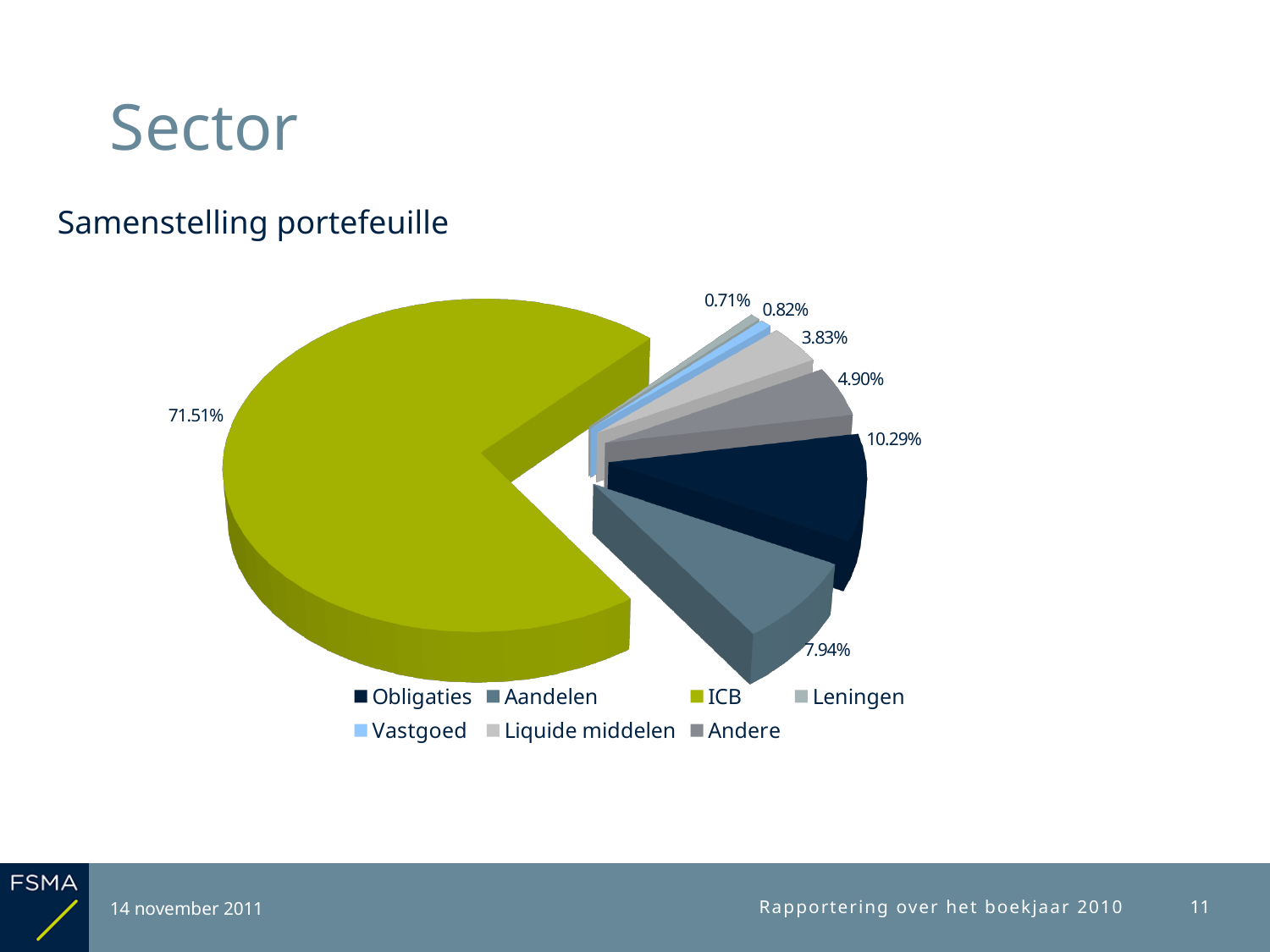
Which category has the largest share of the portfolio? ICB What kind of chart is shown on the slide? pie chart What share of the portfolio is Obligaties? 10.29% What share of the portfolio is ICB? 71.51% What share of the portfolio is Aandelen? 7.94% What is the difference between the shares for Obligaties and Aandelen? 2.35% Which category has the smallest share of the portfolio? Leningen What colour is the ICB slice in the pie chart? green What is the subtitle of the chart on the slide? Samenstelling portefeuille What share of the portfolio is Andere? 4.90% Which is larger, the share for Obligaties or the share for Aandelen? Obligaties How many slices does the pie chart have? 7